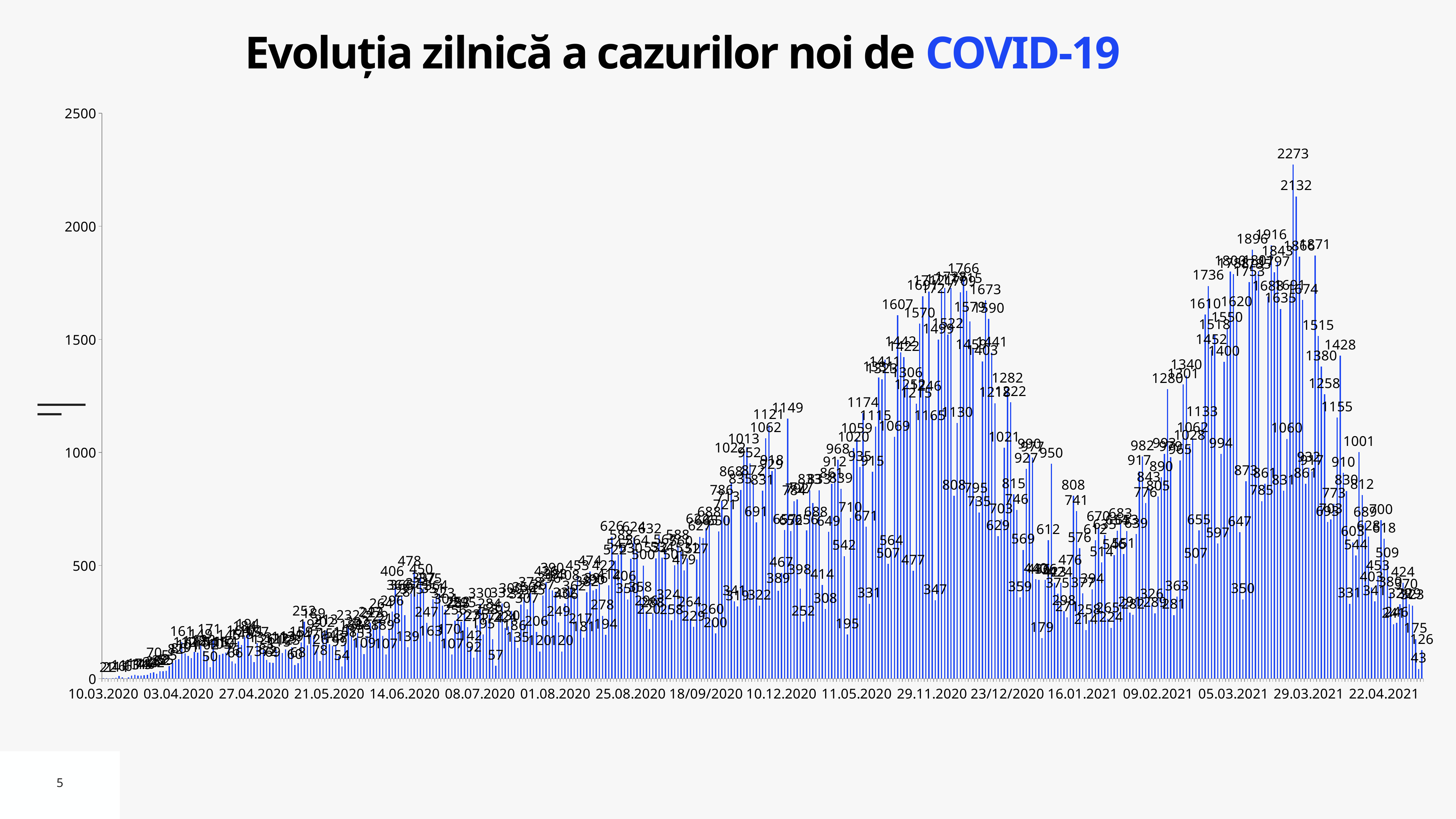
Do the daily values generally rise or fall from 10.03.2020 to 29.11.2020? rise What is the highest daily value labelled on the chart? 2273 What is the title of the chart? Evoluția zilnică a cazurilor noi de COVID-19 What is the value of the last bar on the right of the chart? 126 Is the last bar on the right of the chart greater or less than 500? less What kind of chart is shown on the slide? bar chart What is the maximum value shown on the vertical axis? 2500 What is the second-highest daily value labelled on the chart, next to the 2273 peak? 2132 Is the highest bar on the chart greater or less than 2000? greater What is the difference between the two highest labelled values, 2273 and 2132? 141 What is the first date label on the horizontal axis? 10.03.2020 Which is larger, the peak value 2273 or the neighbouring value 2132? 2273